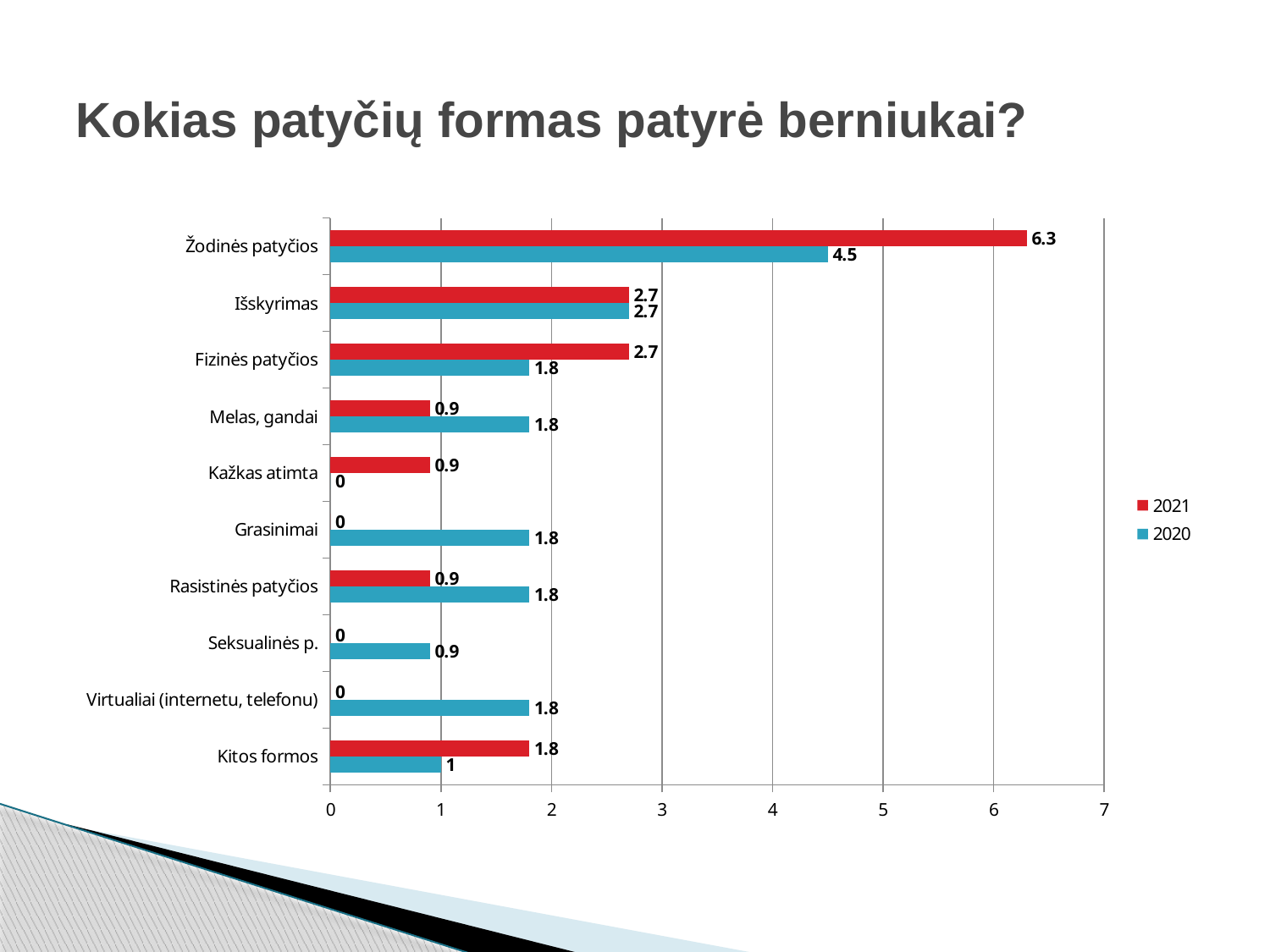
How many categories are shown on the chart? 10 What kind of chart is shown on the slide? Bar chart Which is larger for Fizinės patyčios, the 2021 value or the 2020 value? 2021 Is the 2021 value for Žodinės patyčios greater or less than 6? greater What is the title of the chart on the slide? Kokias patyčių formas patyrė berniukai? What is the 2020 value for Melas, gandai? 1.8 Which colour represents the 2021 series? Red What is the 2020 value for Kitos formos? 1 What is the 2021 value for Žodinės patyčios? 6.3 How many series does the legend list? 2 What is the difference between the 2021 and 2020 values for Žodinės patyčios? 1.8 Which category has the highest 2020 value? Žodinės patyčios